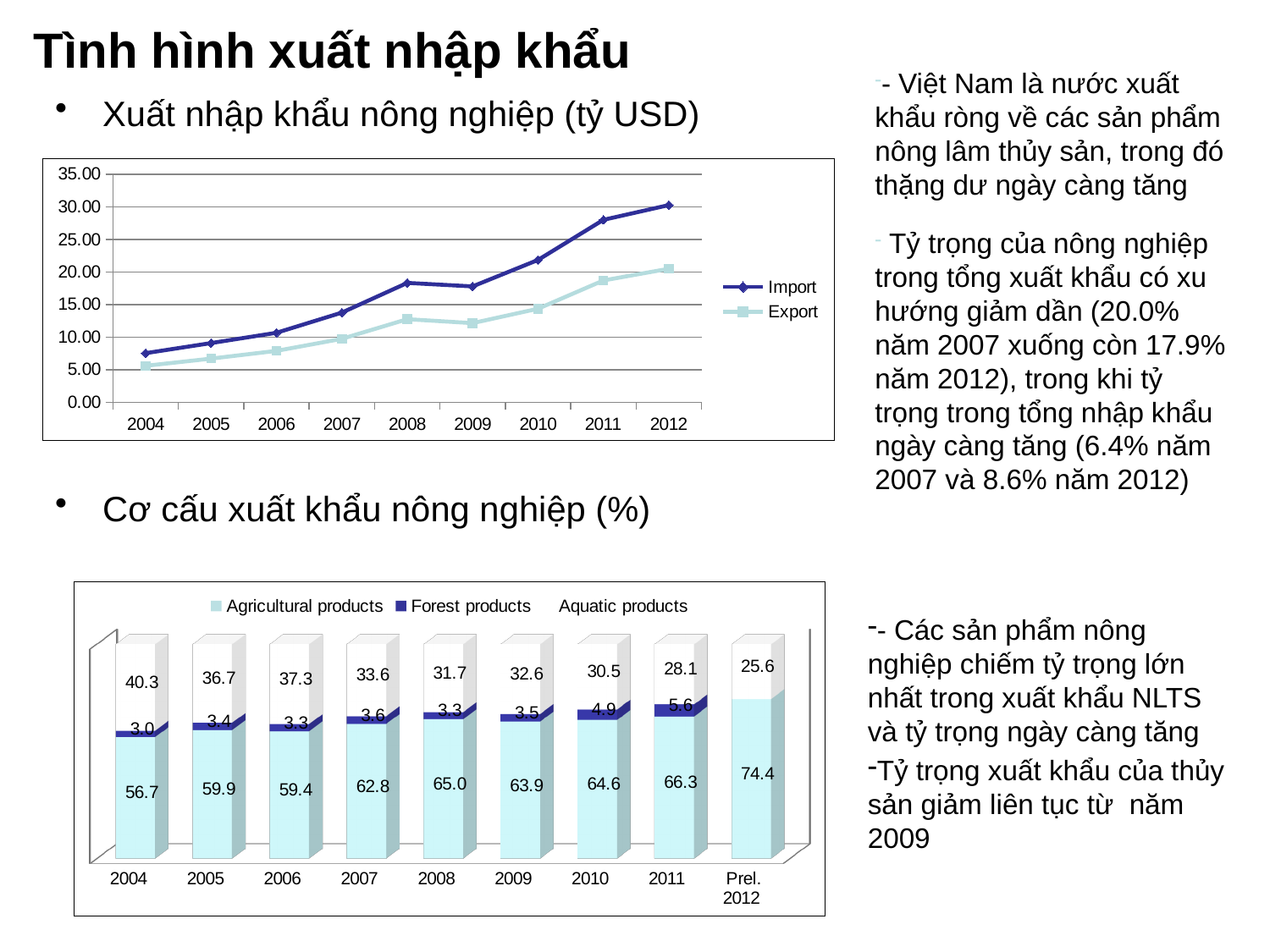
In the top chart (Xuất nhập khẩu nông nghiệp), do the Import values generally rise or fall from 2004 to 2012? rise In the top chart (Xuất nhập khẩu nông nghiệp), is the Export value for 2004 greater or less than 10.00? less In the bottom chart (Cơ cấu xuất khẩu nông nghiệp), what is the value for Forest products in 2011? 5.6 In the top chart (Xuất nhập khẩu nông nghiệp), is the Import value for 2012 greater or less than 25.00? greater In the bottom chart (Cơ cấu xuất khẩu nông nghiệp), what is the value for Agricultural products in 2008? 65.0 In the bottom chart (Cơ cấu xuất khẩu nông nghiệp), which year has the highest Agricultural products value? Prel. 2012 In the top chart (Xuất nhập khẩu nông nghiệp), what kind of chart is shown? line chart In the bottom chart (Cơ cấu xuất khẩu nông nghiệp), what is the difference between the Agricultural products values for Prel. 2012 and 2004? 17.7 In the bottom chart (Cơ cấu xuất khẩu nông nghiệp), what is the value for Aquatic products in 2004? 40.3 In the top chart (Xuất nhập khẩu nông nghiệp), which series is higher in 2011, Import or Export? Import In the bottom chart (Cơ cấu xuất khẩu nông nghiệp), how many series does the legend list? 3 In the top chart (Xuất nhập khẩu nông nghiệp), how many series does the legend list? 2